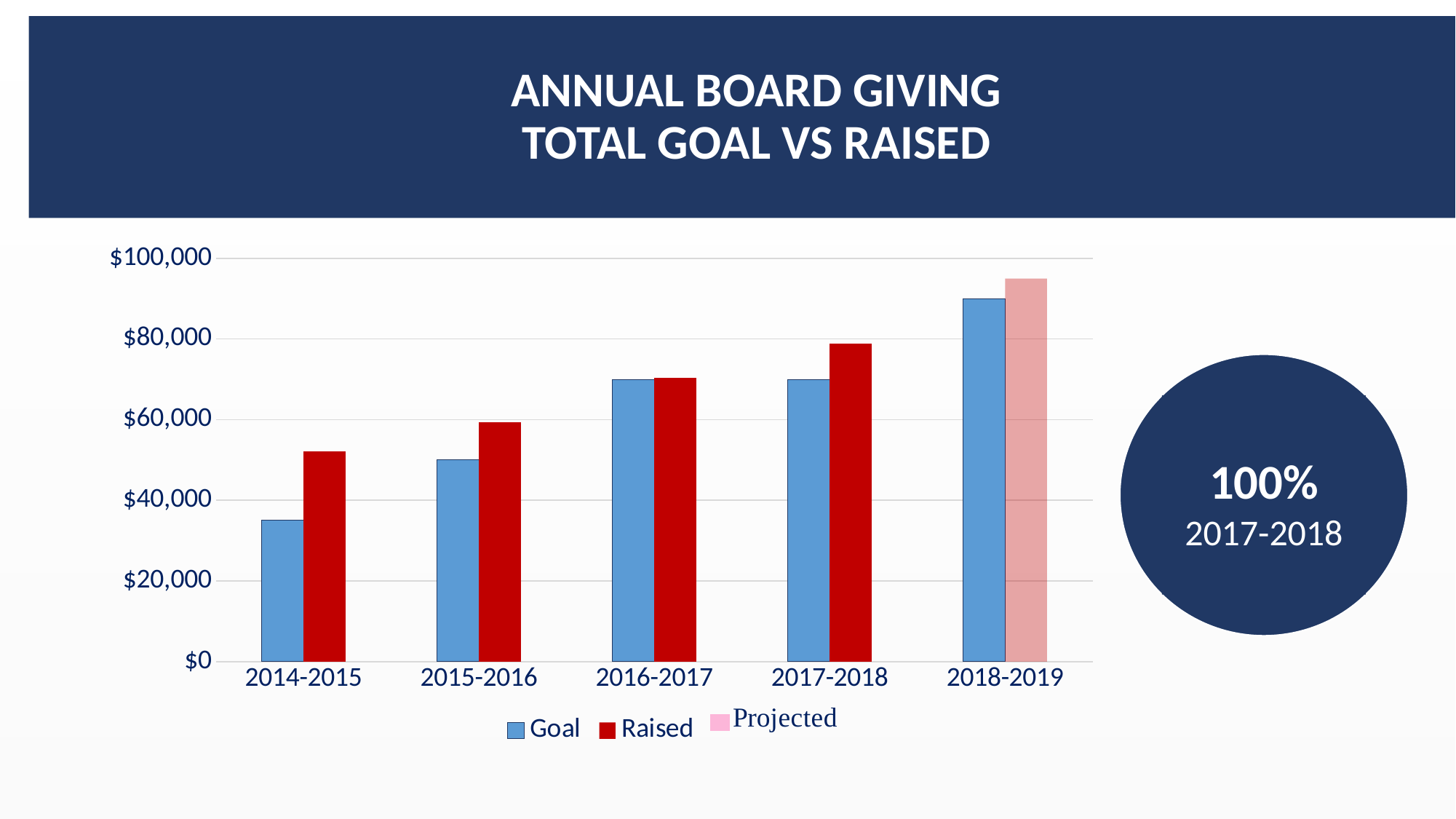
Is the Goal value for 2014-2015 greater or less than $40,000? less What is the title of the chart on the slide? ANNUAL BOARD GIVING TOTAL GOAL VS RAISED Is the Raised value for 2014-2015 greater or less than $40,000? greater What kind of chart is shown on the slide? bar chart Which year has the lowest Goal bar? 2014-2015 Which year has the highest Goal bar? 2018-2019 Which year has the highest Raised bar? 2017-2018 How many series does the legend list? 3 How many fiscal-year categories are shown on the x axis? 5 Do the Goal values rise or fall from 2014-2015 to 2018-2019? rise Is the Goal value for 2018-2019 greater or less than $80,000? greater In 2017-2018, which is larger, the Goal or the Raised value? Raised